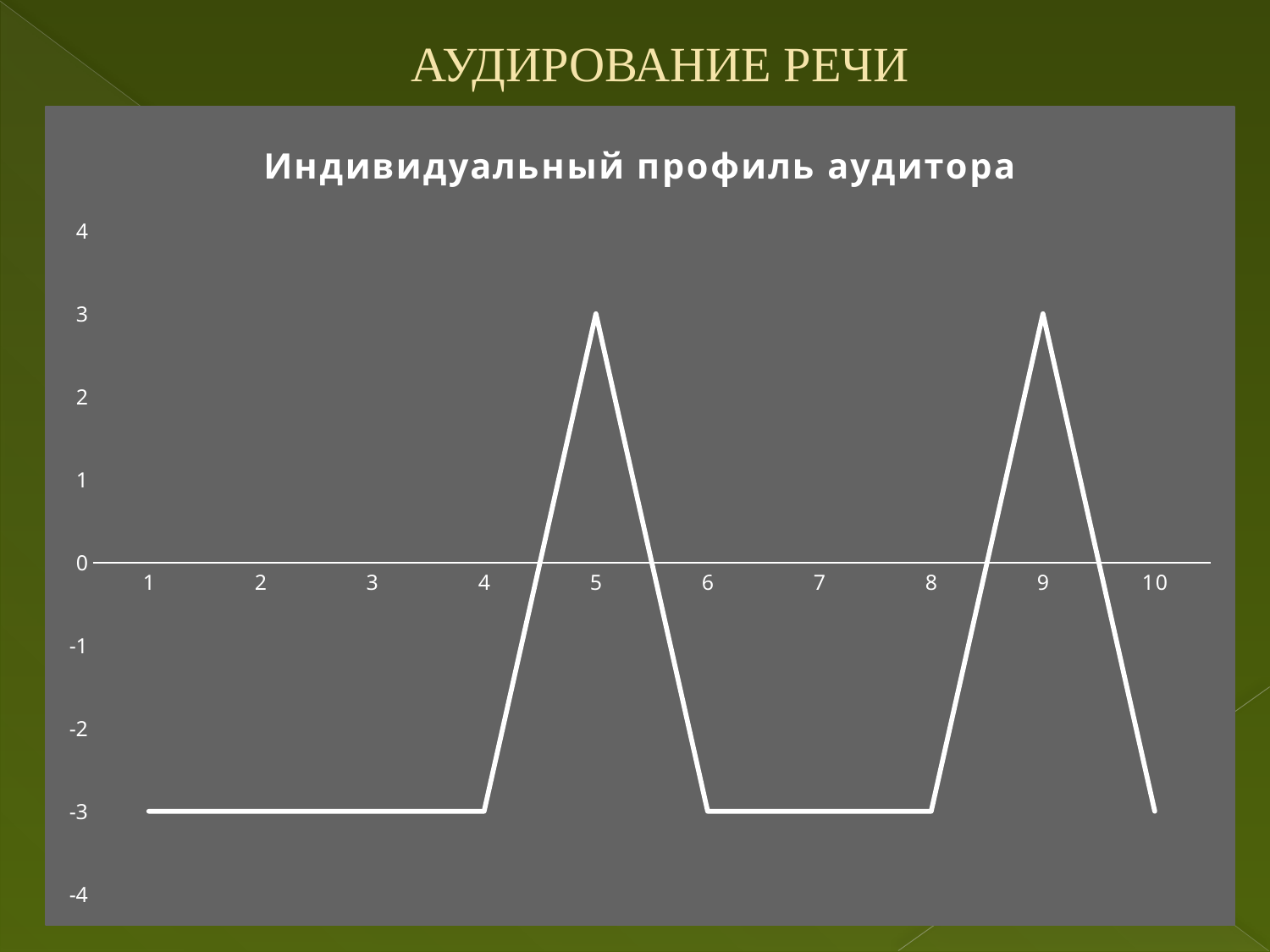
What is the value at point 5? 3 What is the value at point 1? -3 What is the difference between the value at point 5 and the value at point 4? 6 What is the value at point 10? -3 What is the value at point 9? 3 Which is larger, the value at point 9 or the value at point 8? point 9 Does the line rise or fall from point 9 to point 10? fall Is the value at point 5 greater or less than 2? greater How many points are plotted along the x axis? 10 Is the value at point 7 greater or less than 0? less What kind of chart is shown on the slide? line chart What is the title of the chart? Индивидуальный профиль аудитора